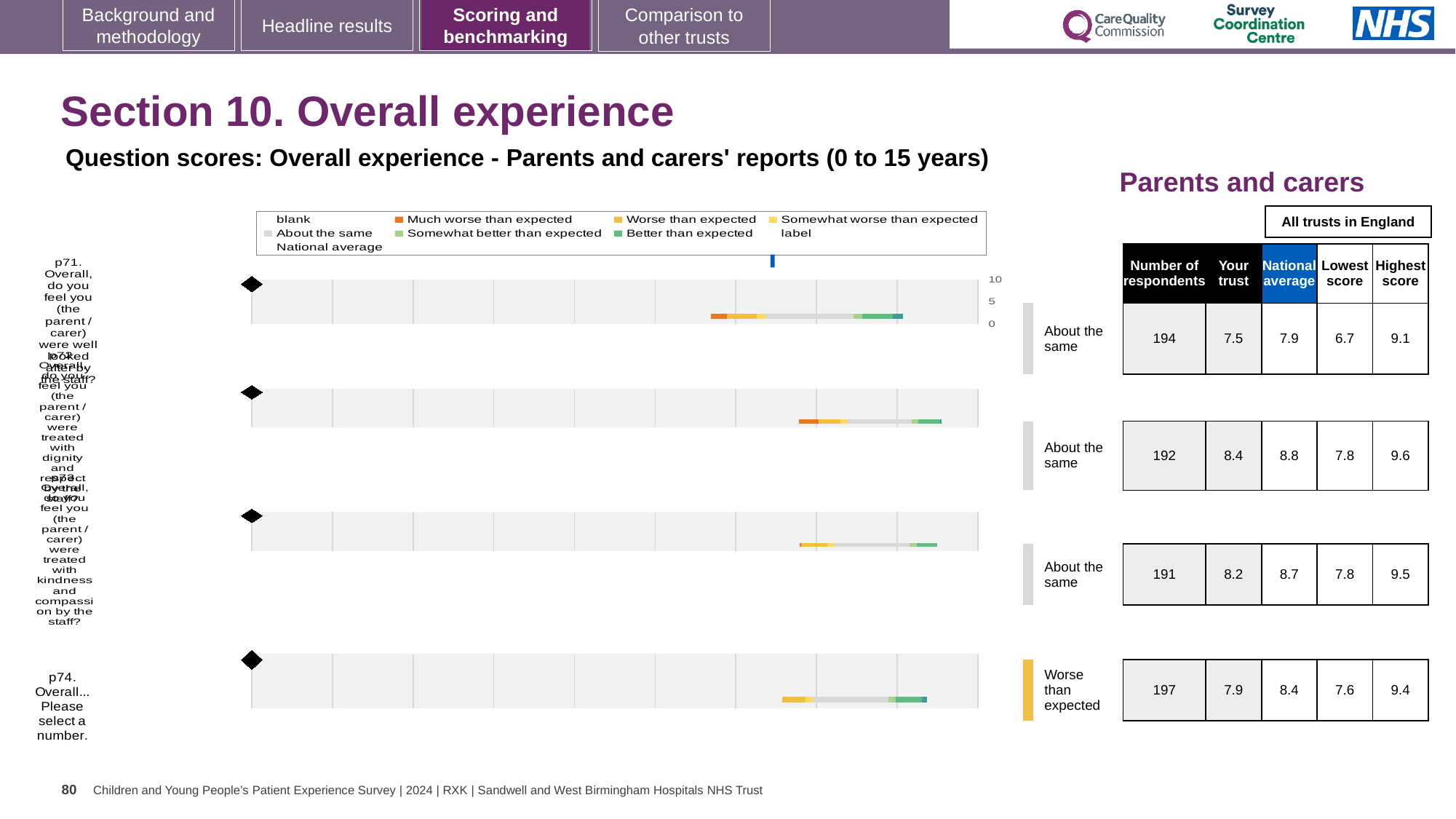
In the table beside the chart, what is the national average for p71? 7.9 In the table beside the chart, how many respondents answered p72? 192 What is the title of the chart on this slide? Question scores: Overall experience - Parents and carers' reports (0 to 15 years) Which question row has the lowest 'Your trust' score in the table beside the chart? p71 What kind of chart is used to show the question scores on this slide? bar chart What is the difference between the highest score and the lowest score for p74 in the table beside the chart? 1.8 For p73, is the 'Your trust' score or the national average larger in the table beside the chart? National average What benchmark category is shown next to the chart row for p71? About the same In the table beside the chart, what is the 'Your trust' score for p74? 7.9 Which question row has the highest number of respondents in the table beside the chart? p74 What benchmark category is shown next to the chart row for p74 (Overall... Please select a number)? Worse than expected How many survey questions (rows) are plotted in the chart? 4